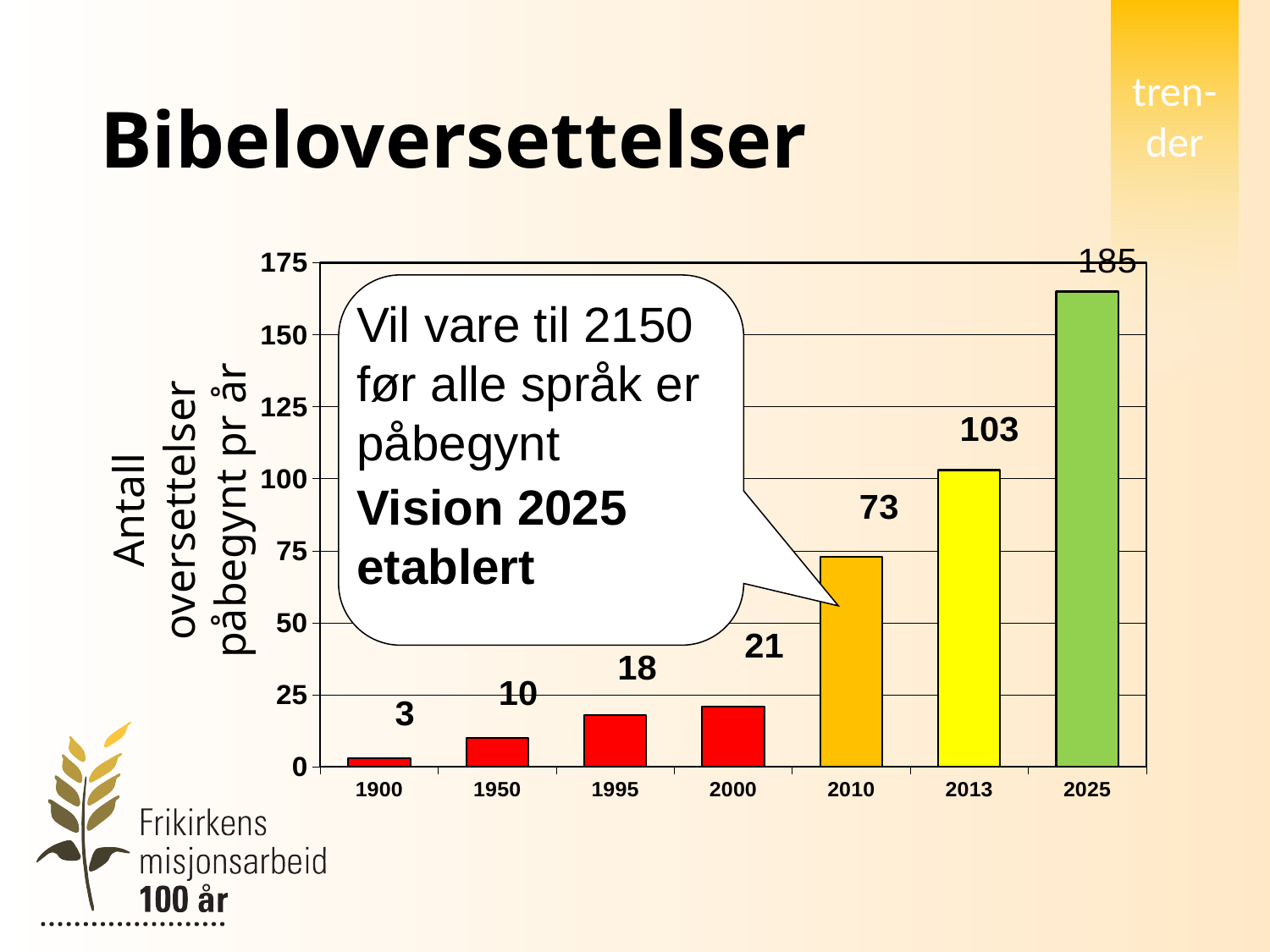
What is the difference between the values for 2000 and 1995? 3 What is the difference between the values for 2013 and 2010? 30 How many years are shown on the x axis? 7 What is the value for 2025? 185 Which year has the lowest value? 1900 Which is larger, the value for 2013 or the value for 2010? 2013 What kind of chart is shown? bar chart What is the value for 1950? 10 Do the values rise or fall from 1900 to 2025? rise Is the value for 2013 greater or less than 100? greater Which year has the highest value? 2025 What is the value for 2010? 73